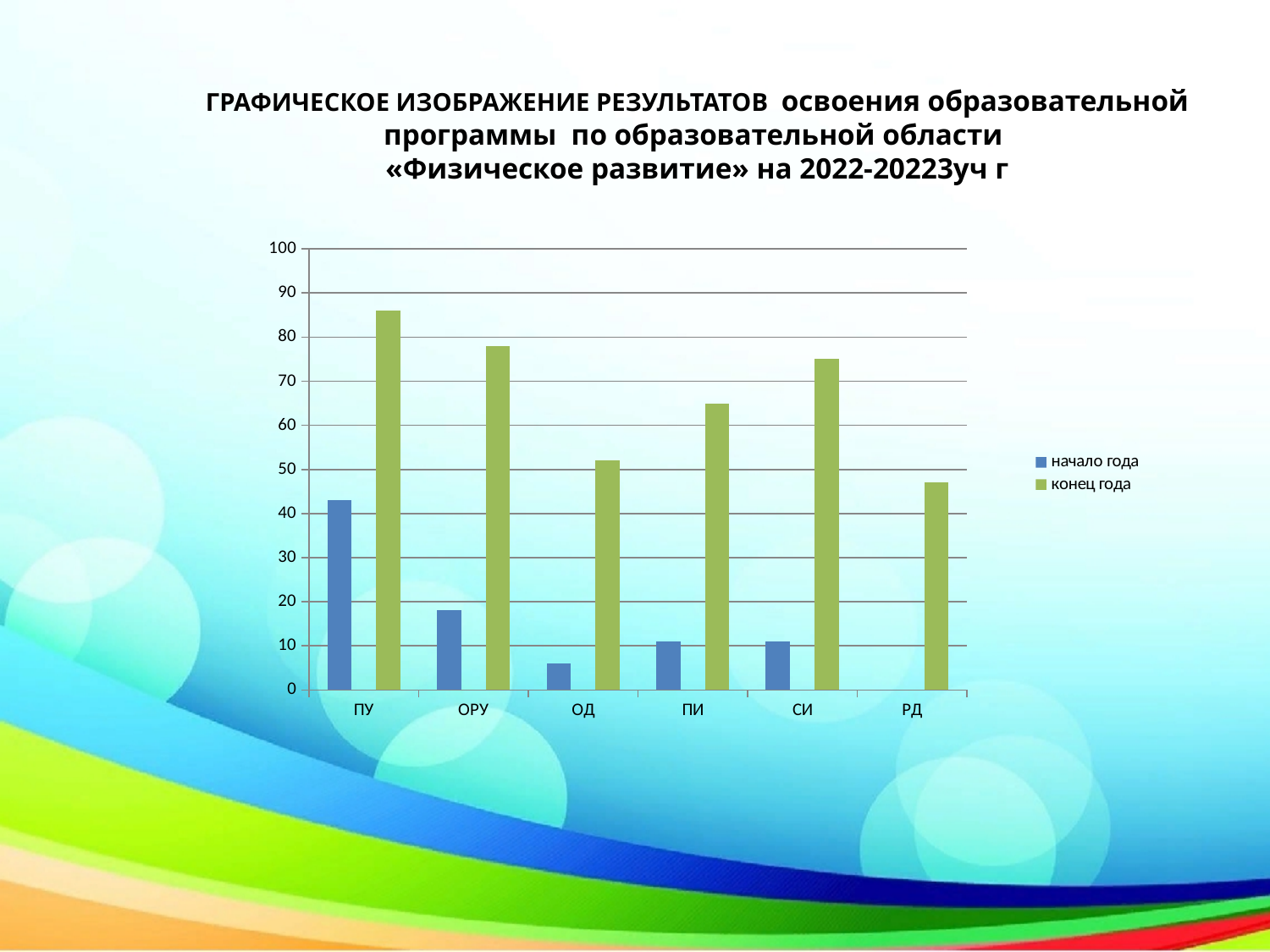
Is the value for ОД in the начало года series greater or less than 10? less Is the value for СИ in the конец года series greater or less than 70? greater Which category has the highest value for конец года? ПУ Is the value for РД in the конец года series greater or less than 50? less What kind of chart is shown on the slide? bar chart What colour are the bars for the конец года series? green Which category has the highest value for начало года? ПУ Which is larger for конец года: ПИ or СИ? СИ How many series does the legend list? 2 How many categories are shown on the x axis? 6